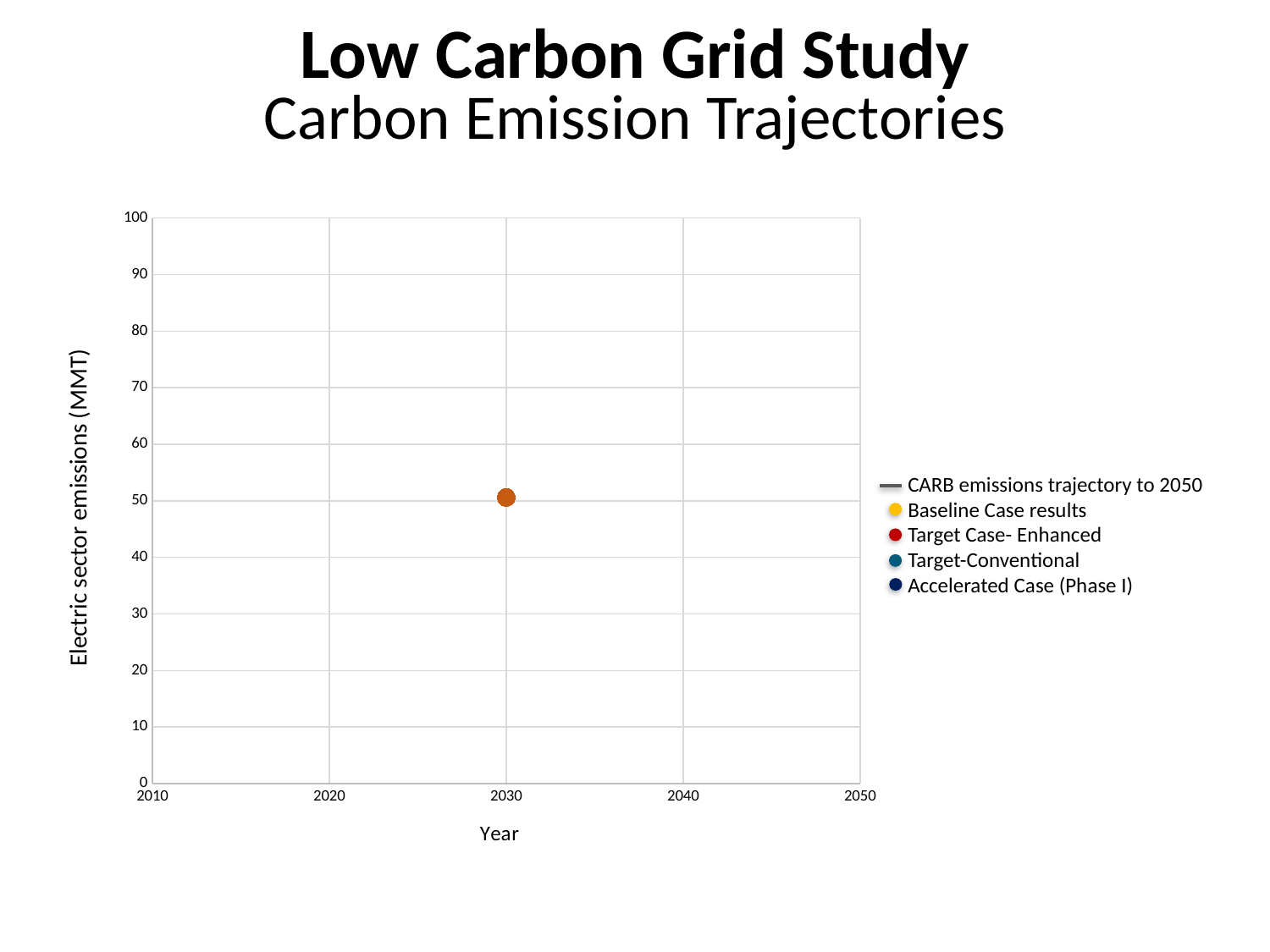
In which year is the plotted data point located? 2030 What kind of chart is shown on the slide? Scatter chart What is the maximum value shown on the vertical axis? 100 What is the last year shown on the horizontal axis? 2050 How many data points are plotted on the chart? 1 What is the title of the chart's horizontal axis? Year Is the value of the plotted point at 2030 greater or less than 40? greater How many series does the legend list? 5 Is the value of the plotted point at 2030 greater or less than 70? less Is the value of the plotted point at 2030 greater or less than 60? less